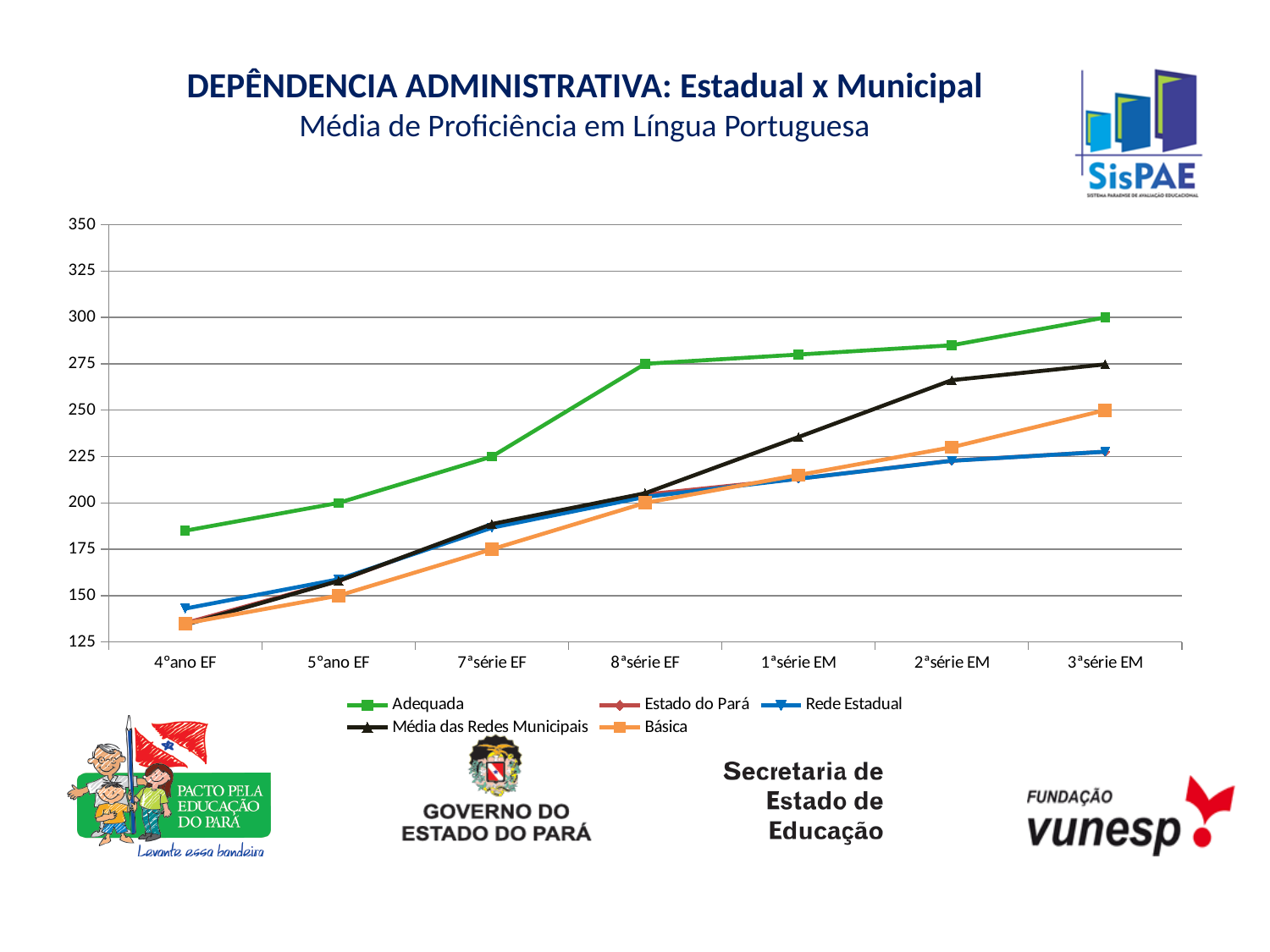
At which category does the Adequada series reach its highest value? 3ª série EM What kind of chart is shown on the slide? line chart What is the value of the Básica series at 3ª série EM? 250 What is the value of the Adequada series at 8ª série EF? 275 How many series does the legend list? 5 What is the difference between the Adequada and Básica values at 8ª série EF? 75 Does the Adequada series rise or fall from 4º ano EF to 3ª série EM? rise How many categories are shown along the x axis? 7 Is the value of Rede Estadual at 3ª série EM greater or less than 250? less Which series is higher at 8ª série EF, Adequada or Básica? Adequada What is the value of the Básica series at 7ª série EF? 175 What is the value of the Adequada series at 3ª série EM? 300